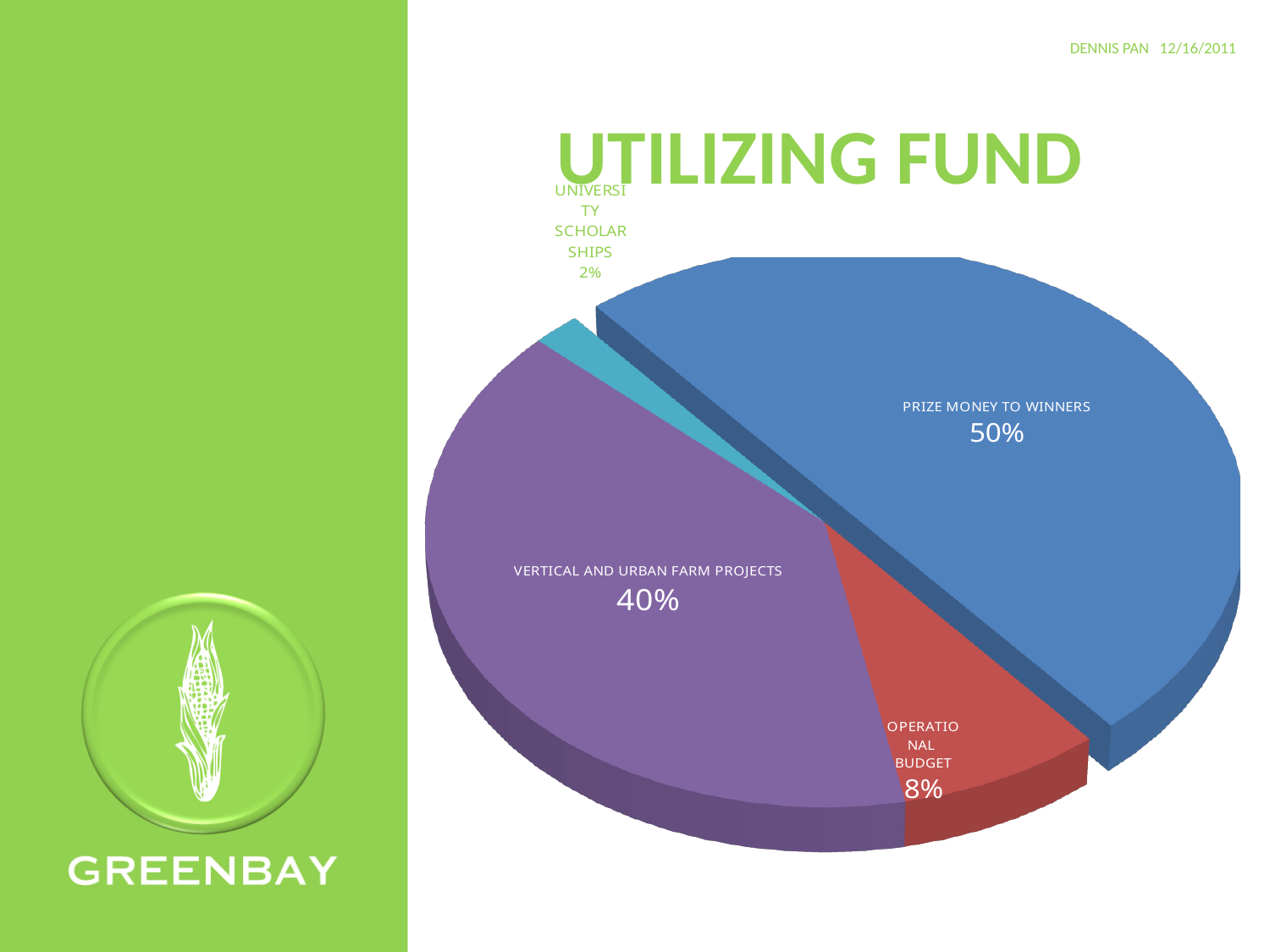
What share of the fund goes to Prize Money to Winners? 50% Which category receives the smallest share of the fund? University Scholarships Which is larger, the share for the Operational Budget or the share for University Scholarships? Operational Budget What is the combined share of the Operational Budget and University Scholarships? 10% What kind of chart is shown on the slide? Pie chart Which category receives the largest share of the fund? Prize Money to Winners What share of the fund goes to University Scholarships? 2% What is the difference in percentage points between Prize Money to Winners and Vertical and Urban Farm Projects? 10 percentage points What share of the fund goes to the Operational Budget? 8% What share of the fund goes to Vertical and Urban Farm Projects? 40% What is the title of the chart on the slide? UTILIZING FUND How many slices does the pie chart have? 4